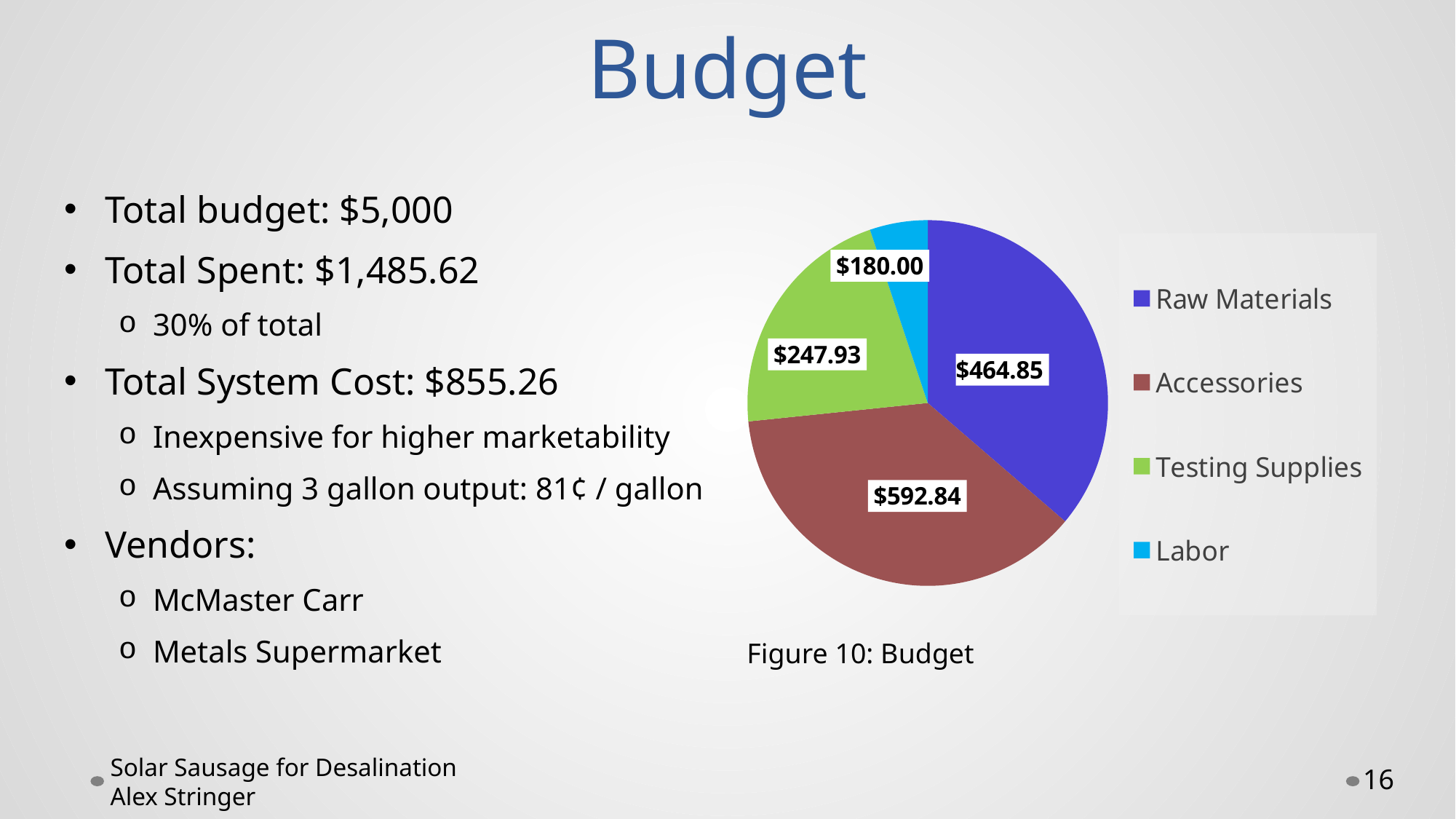
What type of chart is Figure 10: Budget? Pie chart How much larger is the Accessories value than the Raw Materials value in the Budget pie chart? $127.99 What is the value of the Labor slice in the Budget pie chart? $180.00 What is the value of the Testing Supplies slice in the Budget pie chart? $247.93 How many categories are shown in the Budget pie chart? 4 What is the value of the Accessories slice in the Budget pie chart? $592.84 Which category has the largest slice in the Budget pie chart? Accessories What is the value of the Raw Materials slice in the Budget pie chart? $464.85 Which is larger in the Budget pie chart, Raw Materials or Testing Supplies? Raw Materials What is the difference between the Testing Supplies and Labor values in the Budget pie chart? $67.93 What colour is the Labor slice in the Budget pie chart? Light blue Which category has the smallest slice in the Budget pie chart? Labor